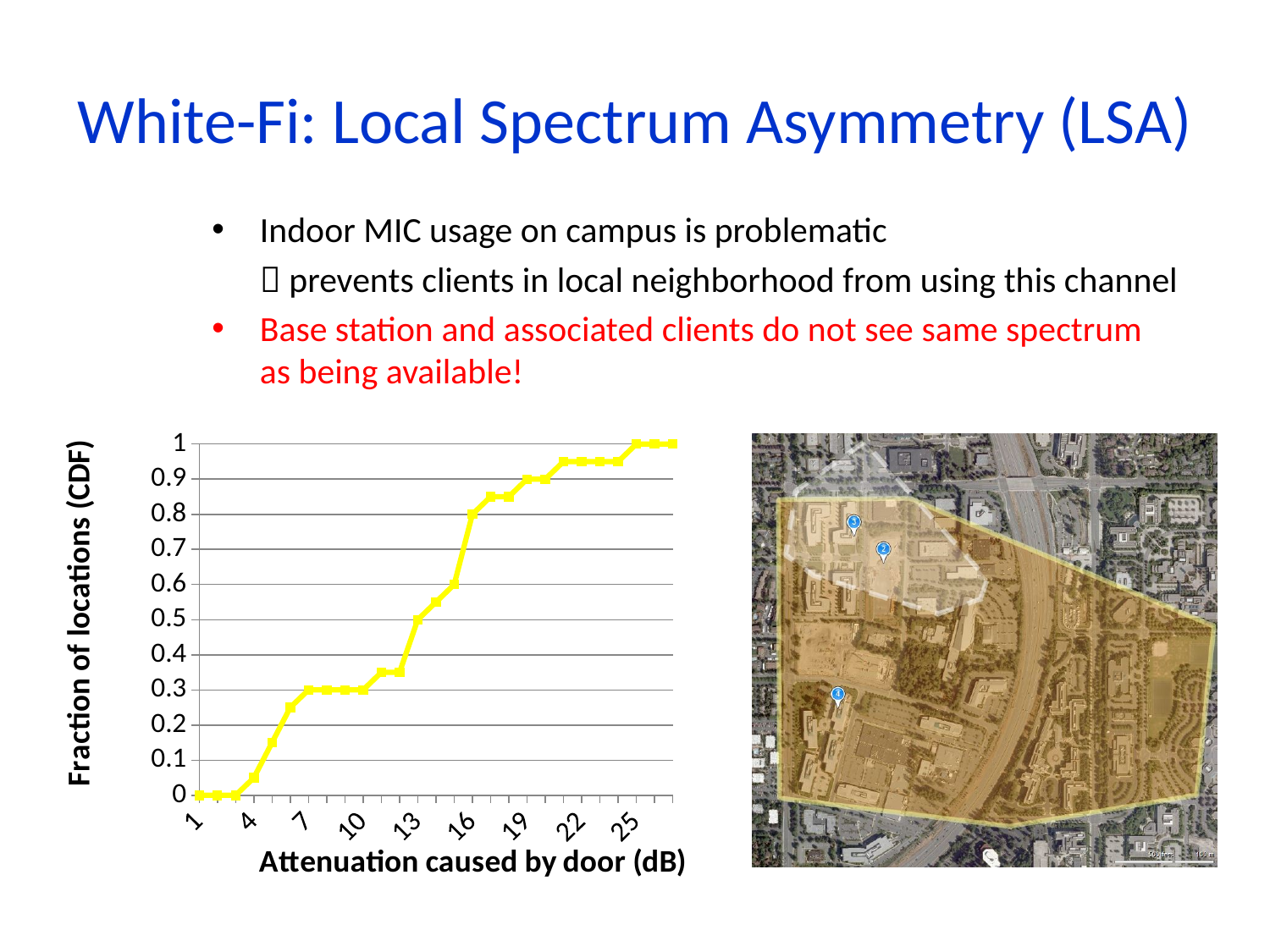
Is the value at 10 dB greater or less than 0.5? less What is the title of the x axis of the chart? Attenuation caused by door (dB) Is the value at 19 dB greater or less than 0.8? greater Do the values rise or fall as attenuation increases along the x axis? rise Is the value at 4 dB greater or less than 0.1? less What is the fraction of locations at an attenuation of 16 dB? 0.8 Which is larger, the value at 13 dB or the value at 7 dB? 13 dB What kind of chart is shown on the slide? line chart What is the fraction of locations at an attenuation of 7 dB? 0.3 What is the title of the y axis of the chart? Fraction of locations (CDF) What is the fraction of locations at an attenuation of 1 dB? 0